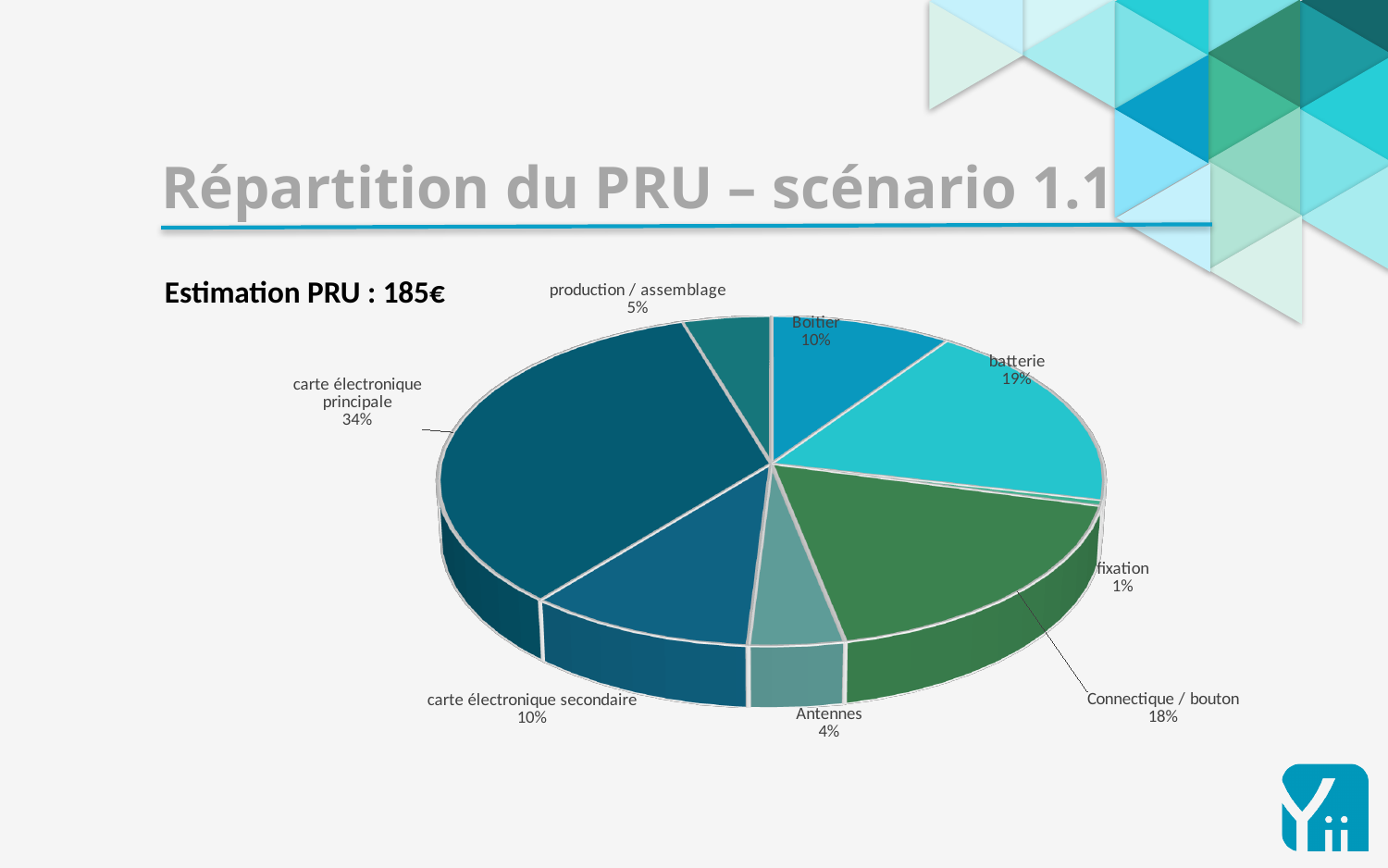
Which category has the smallest share of the pie? fixation What percentage is shown for 'Connectique / bouton'? 18% Which is larger, the share for 'Boitier' or the share for 'Antennes'? Boitier What percentage is shown for 'Antennes'? 4% Which category has the largest share of the pie? carte électronique principale What percentage is shown for 'batterie'? 19% What share of the pie does 'carte électronique principale' represent? 34% What percentage is shown for 'production / assemblage'? 5% What is the difference in percentage points between 'batterie' and 'Connectique / bouton'? 1 How many categories does the pie chart show? 8 What kind of chart is shown on the slide? pie chart What estimated PRU value is stated on the slide next to the chart? 185€